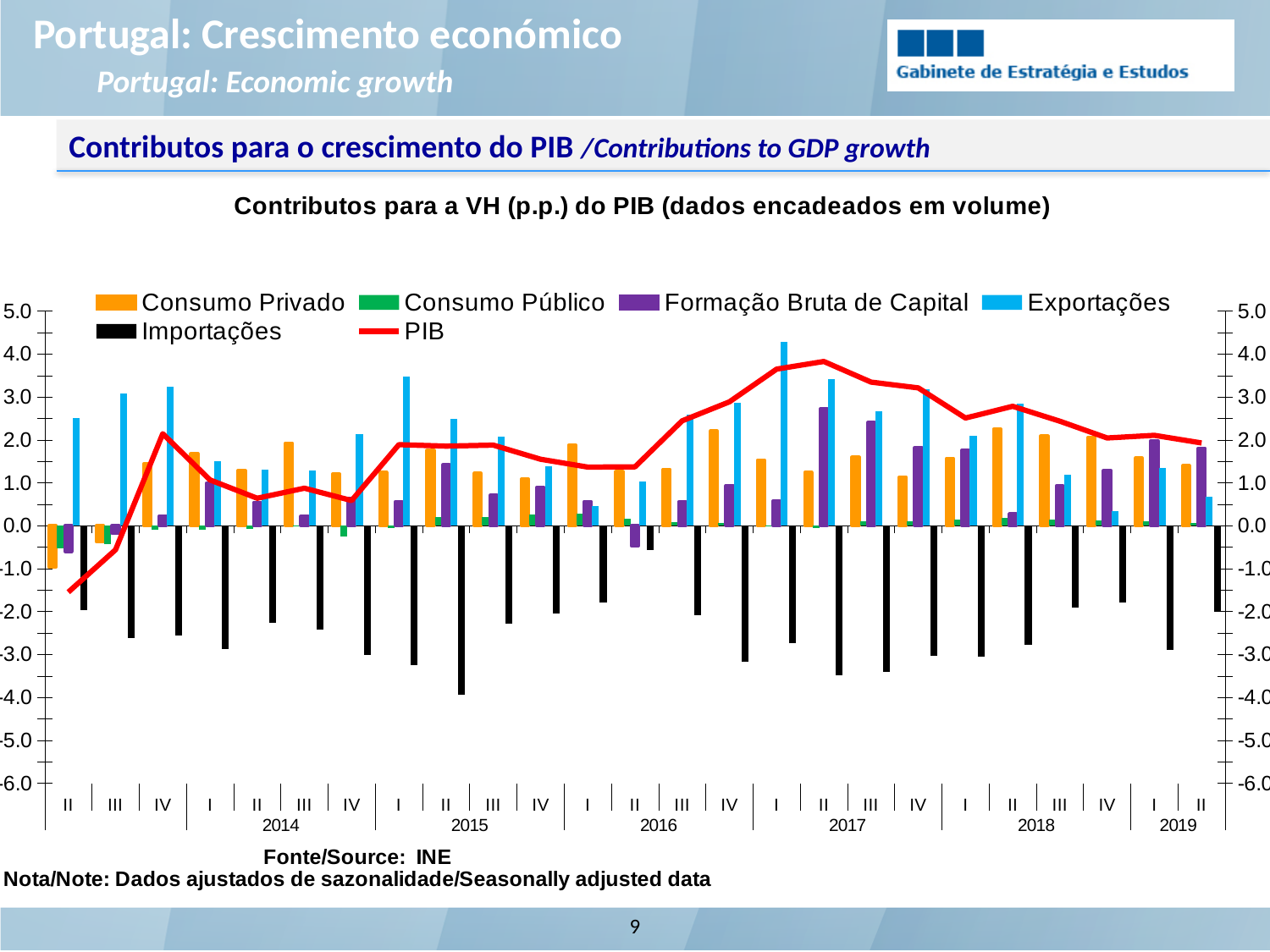
How many series does the chart legend list? 6 Is the Exportações value for 2017 I greater or less than 4.0? greater In which quarter is the Importações bar the lowest (most negative)? 2015 II Is the PIB value for 2017 II greater or less than 3.0? greater In which quarter is the Exportações bar the highest? 2017 I Which series is drawn as a red line rather than bars? PIB How many quarters are plotted along the x axis? 25 What kind of chart is shown on the slide? A combined bar and line chart Does the PIB line rise or fall from 2017 II to 2019 II? Fall Is the Consumo Privado value for 2018 I greater or less than 2.0? less In 2017 I, which is larger: the Exportações bar or the Consumo Privado bar? Exportações